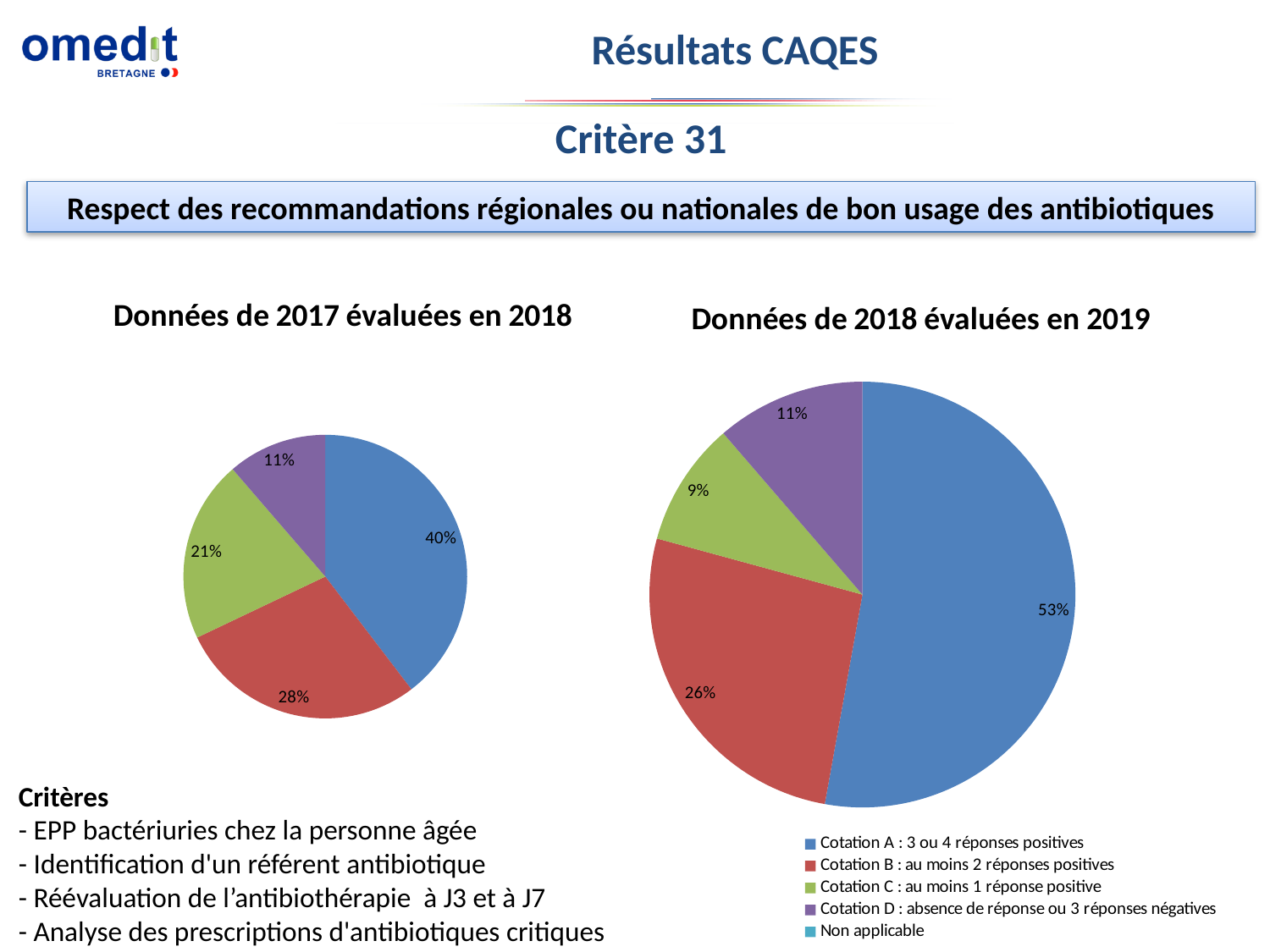
In the chart 'Données de 2017 évaluées en 2018', what share does Cotation A (3 ou 4 réponses positives) represent? 40% What colour represents Cotation D (absence de réponse ou 3 réponses négatives) in the charts? Purple What type of chart is used for 'Données de 2018 évaluées en 2019'? Pie chart In the chart 'Données de 2018 évaluées en 2019', what share does Cotation A (3 ou 4 réponses positives) represent? 53% What is the difference between the Cotation A share in 'Données de 2018 évaluées en 2019' and the Cotation A share in 'Données de 2017 évaluées en 2018'? 13 percentage points In the chart 'Données de 2018 évaluées en 2019', what share does Cotation B (au moins 2 réponses positives) represent? 26% How many entries does the legend list? 5 In the chart 'Données de 2017 évaluées en 2018', which category has the largest slice? Cotation A : 3 ou 4 réponses positives In the chart 'Données de 2017 évaluées en 2018', what share does Cotation C (au moins 1 réponse positive) represent? 21% In the chart 'Données de 2018 évaluées en 2019', which category has the smallest slice? Cotation C : au moins 1 réponse positive How many slices with data labels are shown in the chart 'Données de 2017 évaluées en 2018'? 4 In the chart 'Données de 2017 évaluées en 2018', which is larger: the Cotation B slice or the Cotation C slice? Cotation B